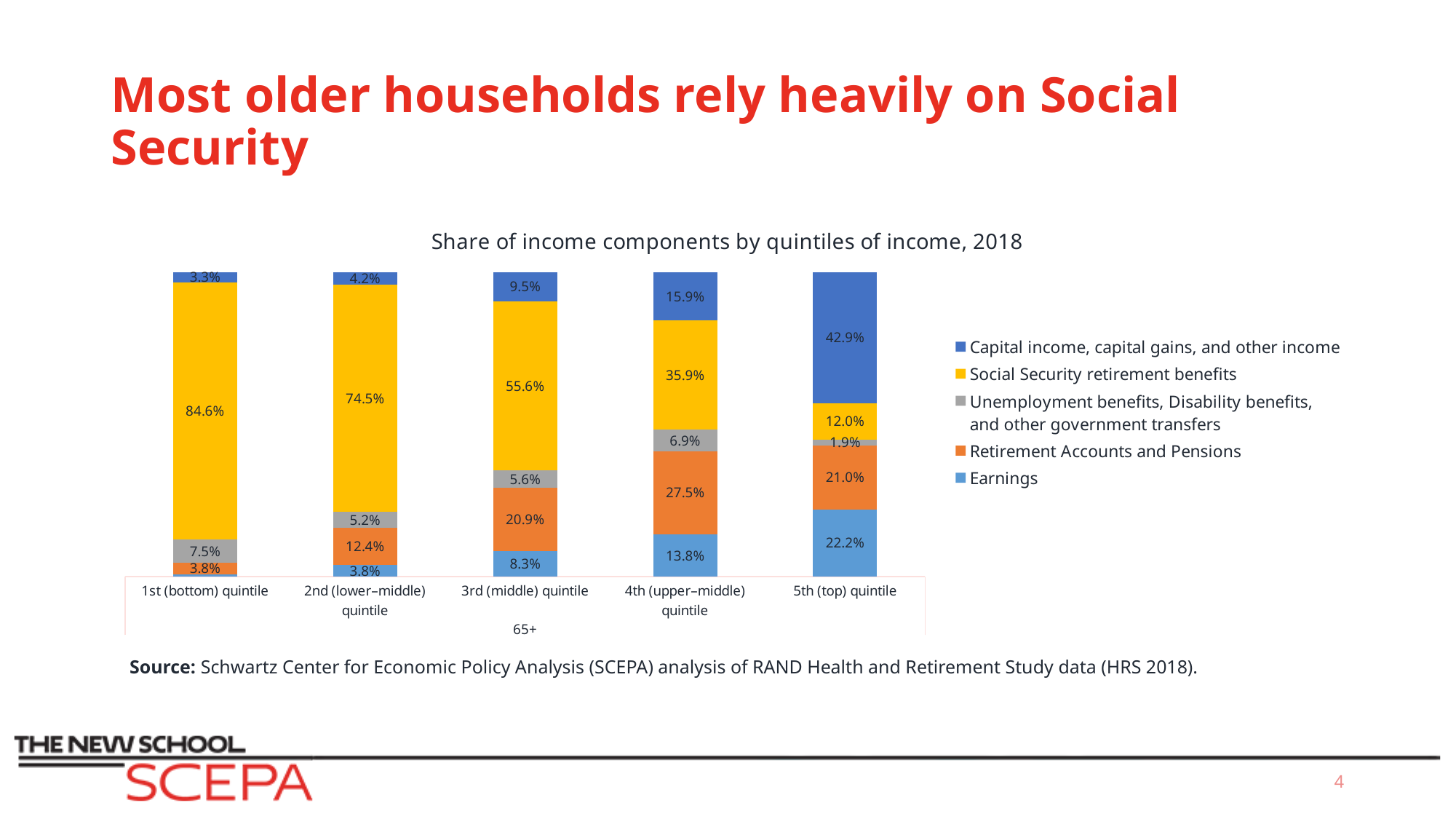
Does the share of Social Security retirement benefits rise or fall from the 1st (bottom) quintile to the 5th (top) quintile? Fall Which quintile has the lowest share of Capital income, capital gains, and other income? 1st (bottom) quintile Which quintile has the highest share of Social Security retirement benefits? 1st (bottom) quintile In the 4th (upper-middle) quintile, how much larger is the Social Security retirement benefits share than the Capital income share? 20.0 percentage points What share of income comes from Retirement Accounts and Pensions in the 4th (upper-middle) quintile? 27.5% How many income components does the legend list? 5 What kind of chart is shown on the slide? Stacked bar chart What is the Earnings share for the 3rd (middle) quintile? 8.3% What is the share of Capital income, capital gains, and other income for the 5th (top) quintile? 42.9% What share of income comes from Social Security retirement benefits for the 1st (bottom) quintile? 84.6% How many quintiles are shown on the x axis? 5 In the 5th (top) quintile, which is larger: the Earnings share or the Retirement Accounts and Pensions share? Earnings